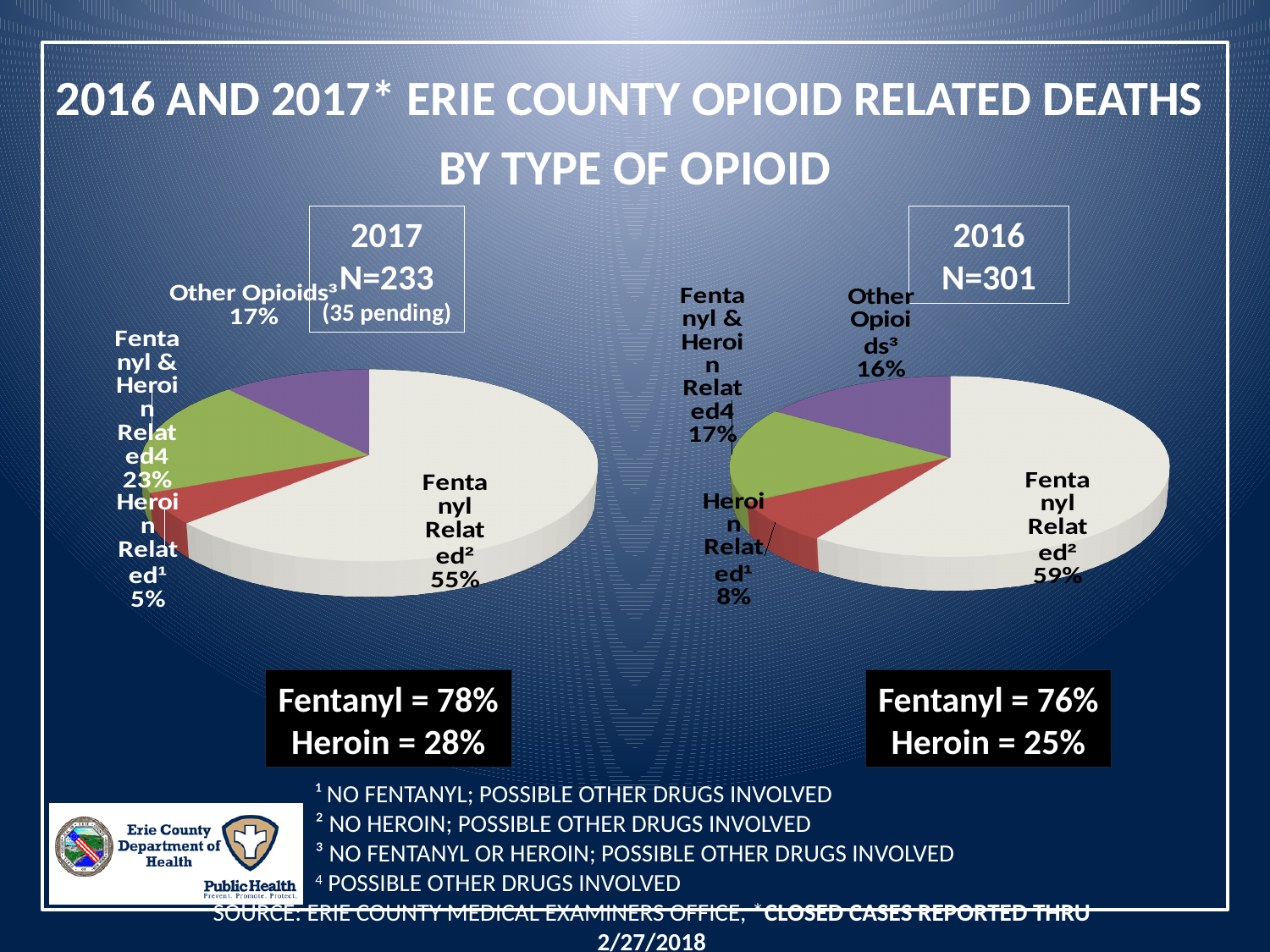
What is the N value shown for the 2016 chart? N=301 In the 2016 pie chart, which category has the largest slice? Fentanyl Related In the 2017 pie chart, what is the difference between the Fentanyl Related share and the Fentanyl & Heroin Related share? 32 percentage points In the 2016 pie chart, what share of opioid related deaths is Fentanyl Related? 59% Which is larger: the Other Opioids share in 2017 or the Other Opioids share in 2016? 2017 What type of chart is used to show the 2017 opioid related deaths? Pie chart How many slices does the 2016 pie chart have? 4 In the 2017 pie chart, what share of opioid related deaths is Fentanyl Related? 55% How many cases are noted as pending for the 2017 chart? 35 pending In the 2017 pie chart, which category has the smallest slice? Heroin Related In the 2016 pie chart, what percentage is labelled Heroin Related? 8% In the 2017 pie chart, what percentage is labelled Fentanyl & Heroin Related? 23%